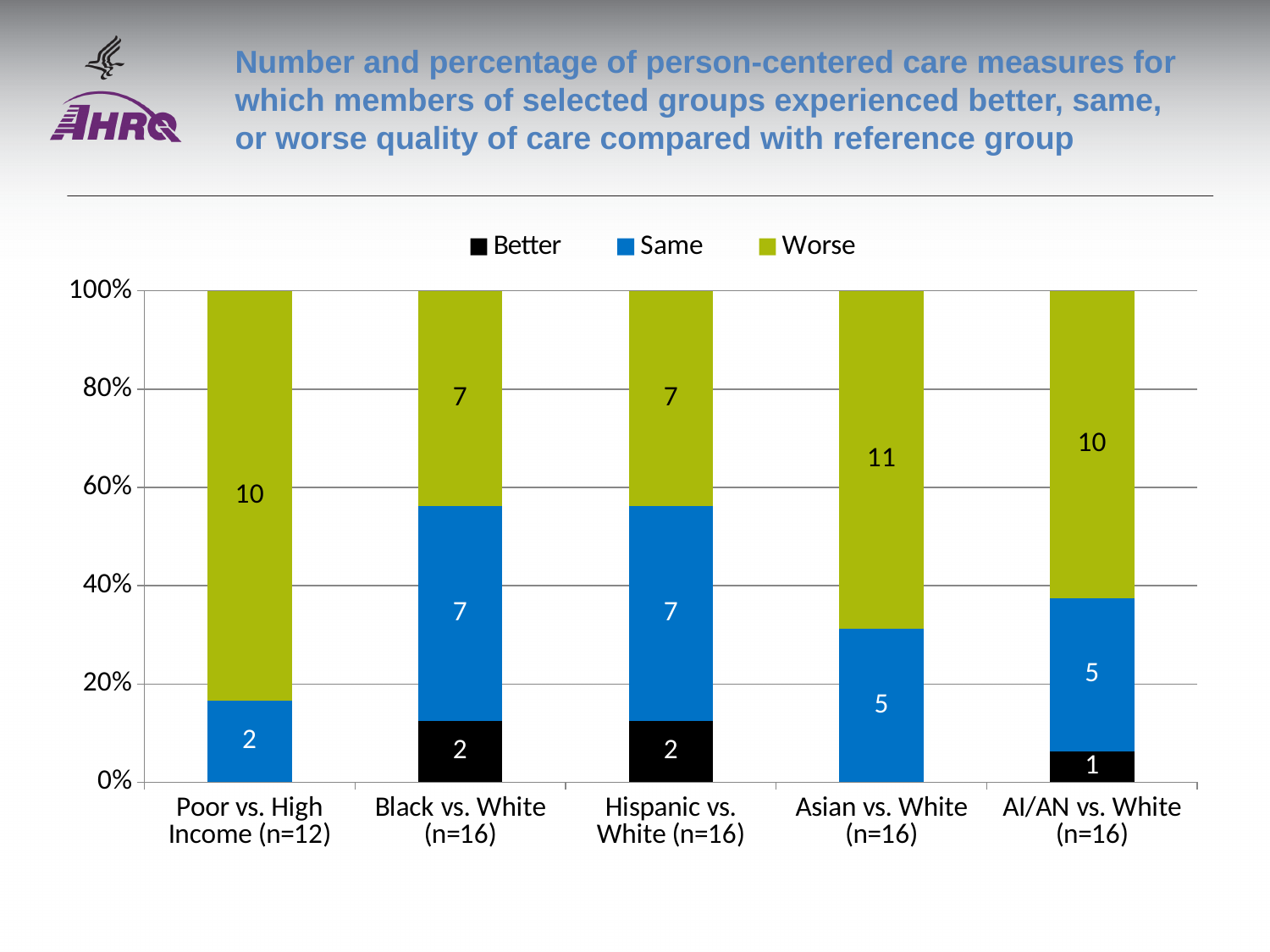
What is the difference between the 'Worse' count for Asian vs. White and the 'Worse' count for Black vs. White? 4 What is the total of the labelled segments for the AI/AN vs. White bar? 16 What is the number of 'Same' measures for Poor vs. High Income? 2 What is the number of 'Same' measures for AI/AN vs. White? 5 What is the number of 'Better' measures for Hispanic vs. White? 2 How many groups are shown on the x axis? 5 How many series does the legend list? 3 What kind of chart is shown on the slide? Stacked bar chart What is the number of 'Worse' measures for Asian vs. White? 11 Which group has the highest number of 'Worse' measures? Asian vs. White Which is larger: the 'Same' count for Black vs. White or the 'Same' count for Asian vs. White? Black vs. White Which group has the lowest number of 'Better' measures among those with a 'Better' label? AI/AN vs. White